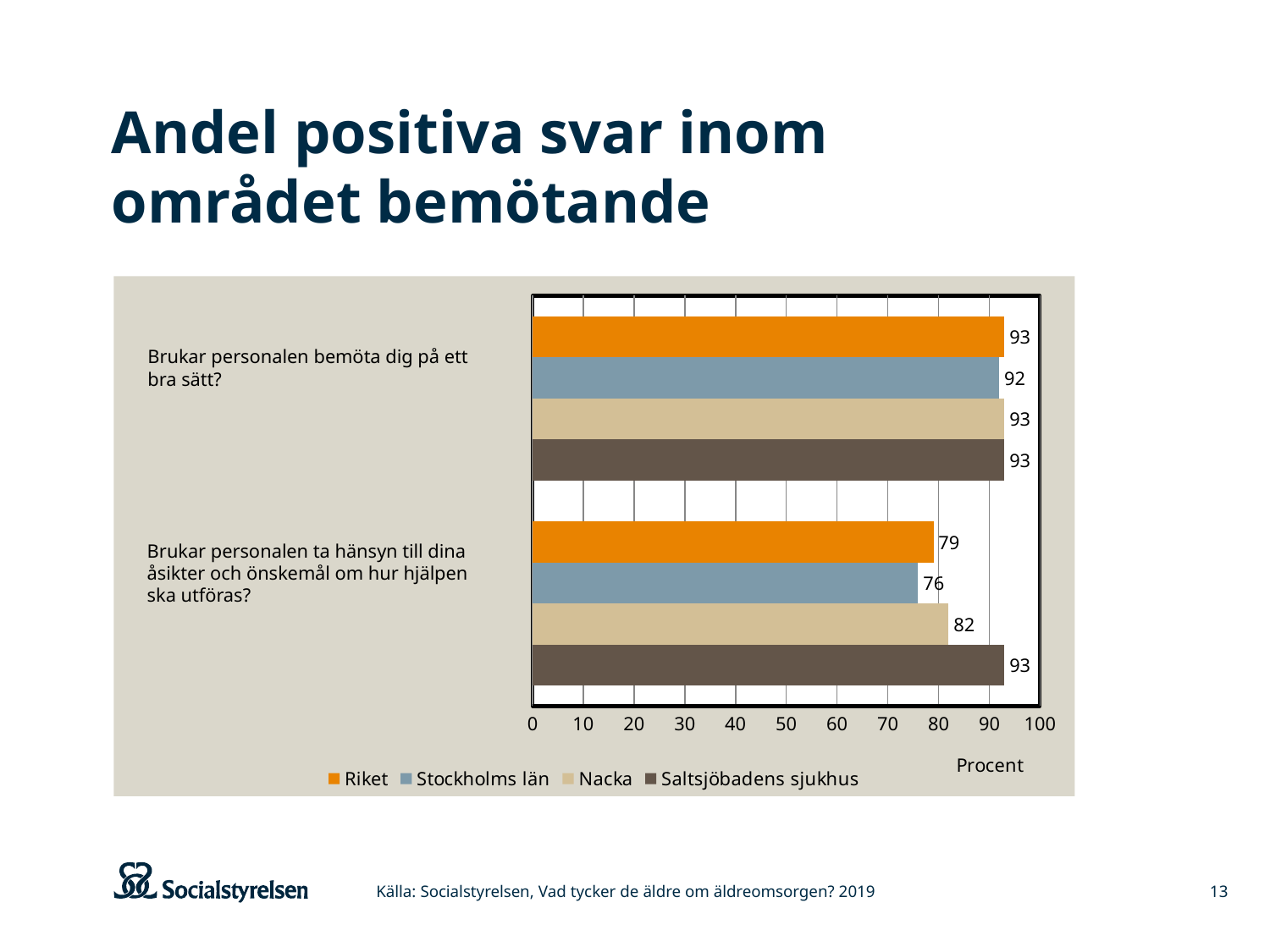
How many question categories are shown on the chart? 2 What is the value for Stockholms län on the question "Brukar personalen bemöta dig på ett bra sätt?"? 92 How many series does the legend list? 4 What is the value for Riket on the question "Brukar personalen ta hänsyn till dina åsikter och önskemål om hur hjälpen ska utföras?"? 79 What is the difference between the Saltsjöbadens sjukhus value and the Stockholms län value on the question "Brukar personalen ta hänsyn till dina åsikter och önskemål om hur hjälpen ska utföras?"? 17 What is the value for Nacka on the question "Brukar personalen ta hänsyn till dina åsikter och önskemål om hur hjälpen ska utföras?"? 82 Which series has the highest value on the question "Brukar personalen ta hänsyn till dina åsikter och önskemål om hur hjälpen ska utföras?"? Saltsjöbadens sjukhus Which series has the lowest value on the question "Brukar personalen ta hänsyn till dina åsikter och önskemål om hur hjälpen ska utföras?"? Stockholms län On the question "Brukar personalen ta hänsyn till dina åsikter och önskemål om hur hjälpen ska utföras?", which is larger, the value for Riket or the value for Nacka? Nacka What is the label on the horizontal axis of the chart? Procent What kind of chart is shown on the slide? Bar chart What is the value for Saltsjöbadens sjukhus on the question "Brukar personalen ta hänsyn till dina åsikter och önskemål om hur hjälpen ska utföras?"? 93